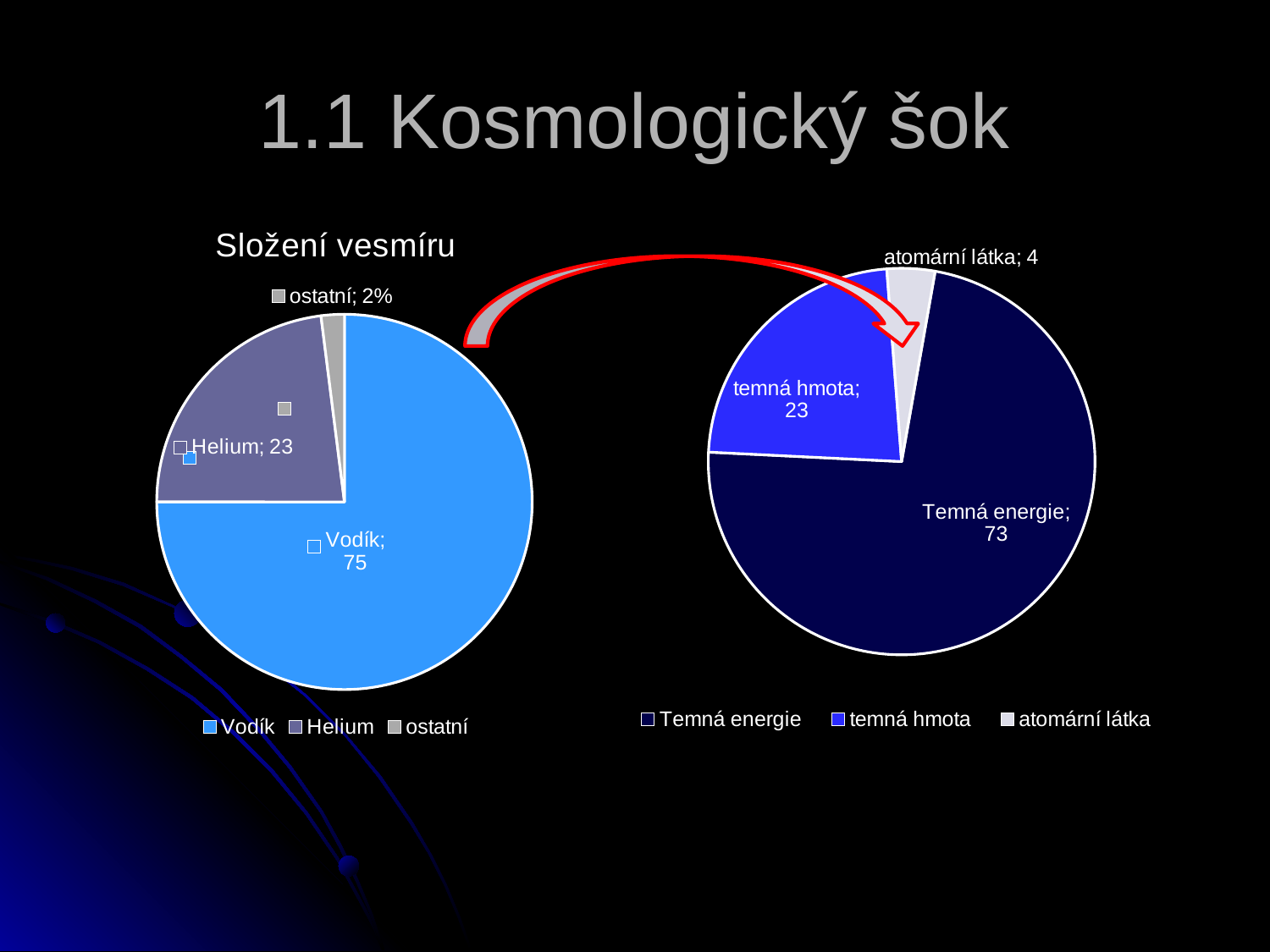
How many categories does the legend of the right-hand pie chart list? 3 In the 'Složení vesmíru' pie chart, what value is shown for Vodík? 75 In the 'Složení vesmíru' pie chart, which category has the largest slice? Vodík In the 'Složení vesmíru' pie chart, which category has the smallest slice? ostatní In the right-hand pie chart, what value is shown for Temná energie? 73 What type of chart is the 'Složení vesmíru' chart? pie chart In the 'Složení vesmíru' pie chart, what value is shown for Helium? 23 In the right-hand pie chart, which is larger: temná hmota or atomární látka? temná hmota In the 'Složení vesmíru' pie chart, what is the difference between the values for Vodík and Helium? 52 In the right-hand pie chart, which category has the largest slice? Temná energie In the 'Složení vesmíru' pie chart, what value is shown for ostatní? 2% In the right-hand pie chart, what value is shown for atomární látka? 4